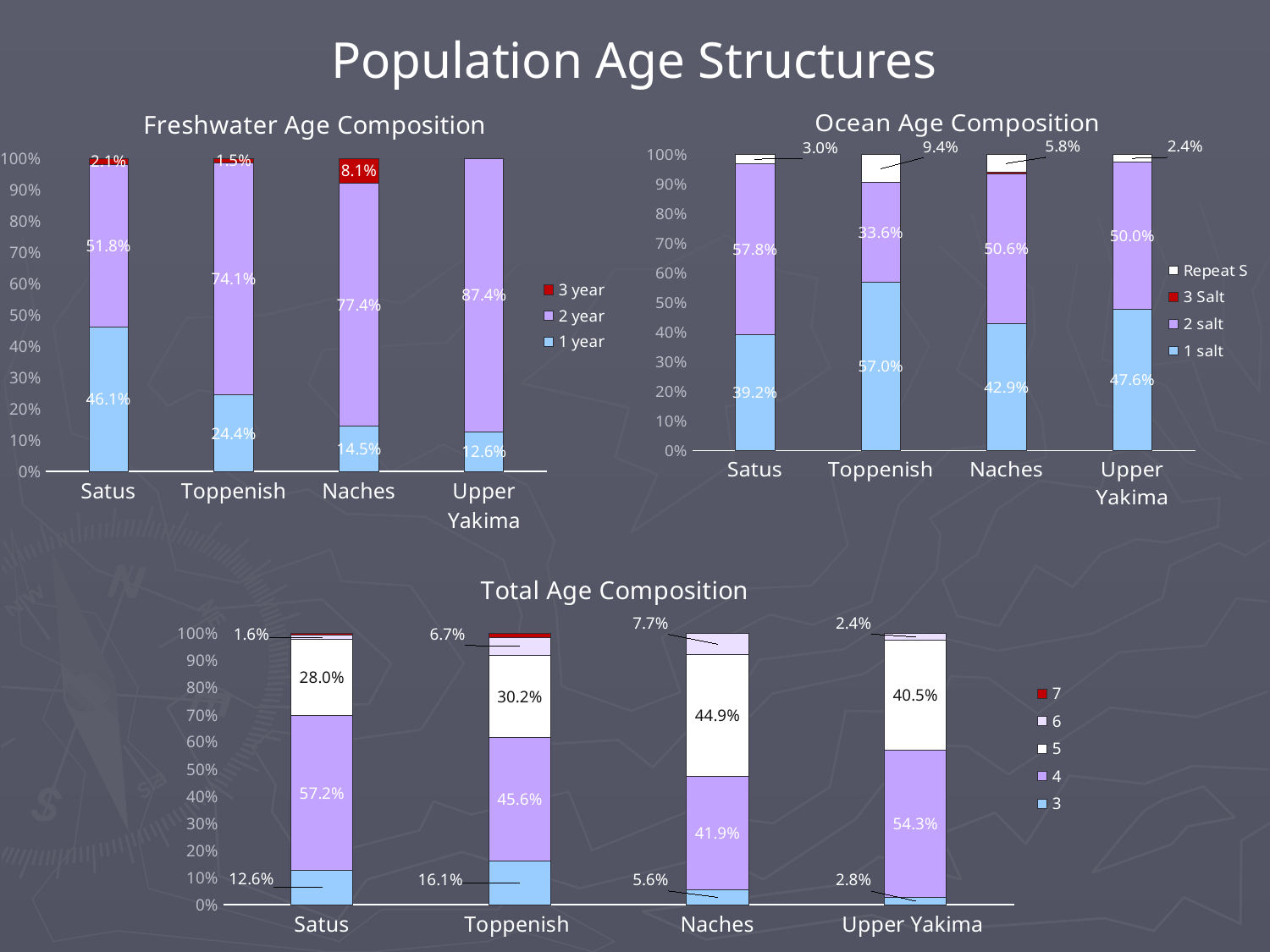
What kind of chart is the Freshwater Age Composition chart? Stacked bar chart In the Freshwater Age Composition chart, what is the difference between the 2 year values for Naches and Toppenish? 3.3% In the Ocean Age Composition chart, is the 2 salt value larger for Satus or Naches? Satus In the Freshwater Age Composition chart, what is the 1 year value for Satus? 46.1% In the Ocean Age Composition chart, which category has the lowest Repeat S value? Upper Yakima In the Total Age Composition chart, what is the difference between the series 4 values for Satus and Toppenish? 11.6% In the Ocean Age Composition chart, what is the 1 salt value for Toppenish? 57.0% In the Ocean Age Composition chart, how many series does the legend list? 4 In the Total Age Composition chart, which category has the lowest value for series 3? Upper Yakima How many categories are shown on the x axis of the Total Age Composition chart? 4 In the Total Age Composition chart, what is the value for series 5 for Naches? 44.9% In the Freshwater Age Composition chart, which category has the highest 2 year value? Upper Yakima